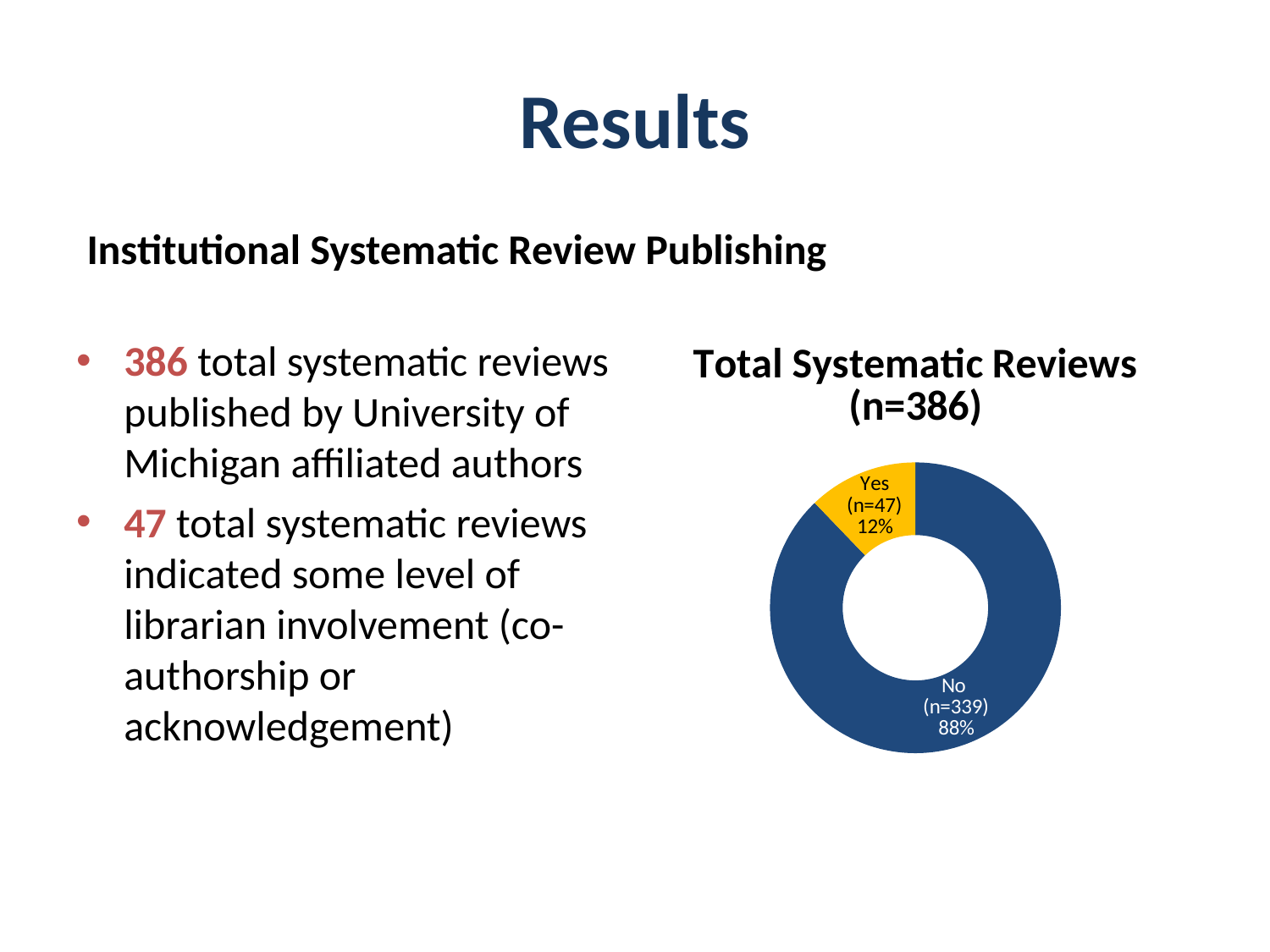
How many slices does the chart have? 2 Which slice is larger, "Yes" or "No"? No What colour is the "Yes" slice? Yellow Which slice is the smallest? Yes What is the title of the chart? Total Systematic Reviews (n=386) Which slice is the largest? No What percentage of the chart is the "No" slice? 88% What is the count (n) shown for the "Yes" slice? 47 What kind of chart is shown on the slide? Doughnut chart What percentage of the chart is the "Yes" slice? 12% What is the difference in percentage points between the "No" and "Yes" slices? 76 What is the count (n) shown for the "No" slice? 339